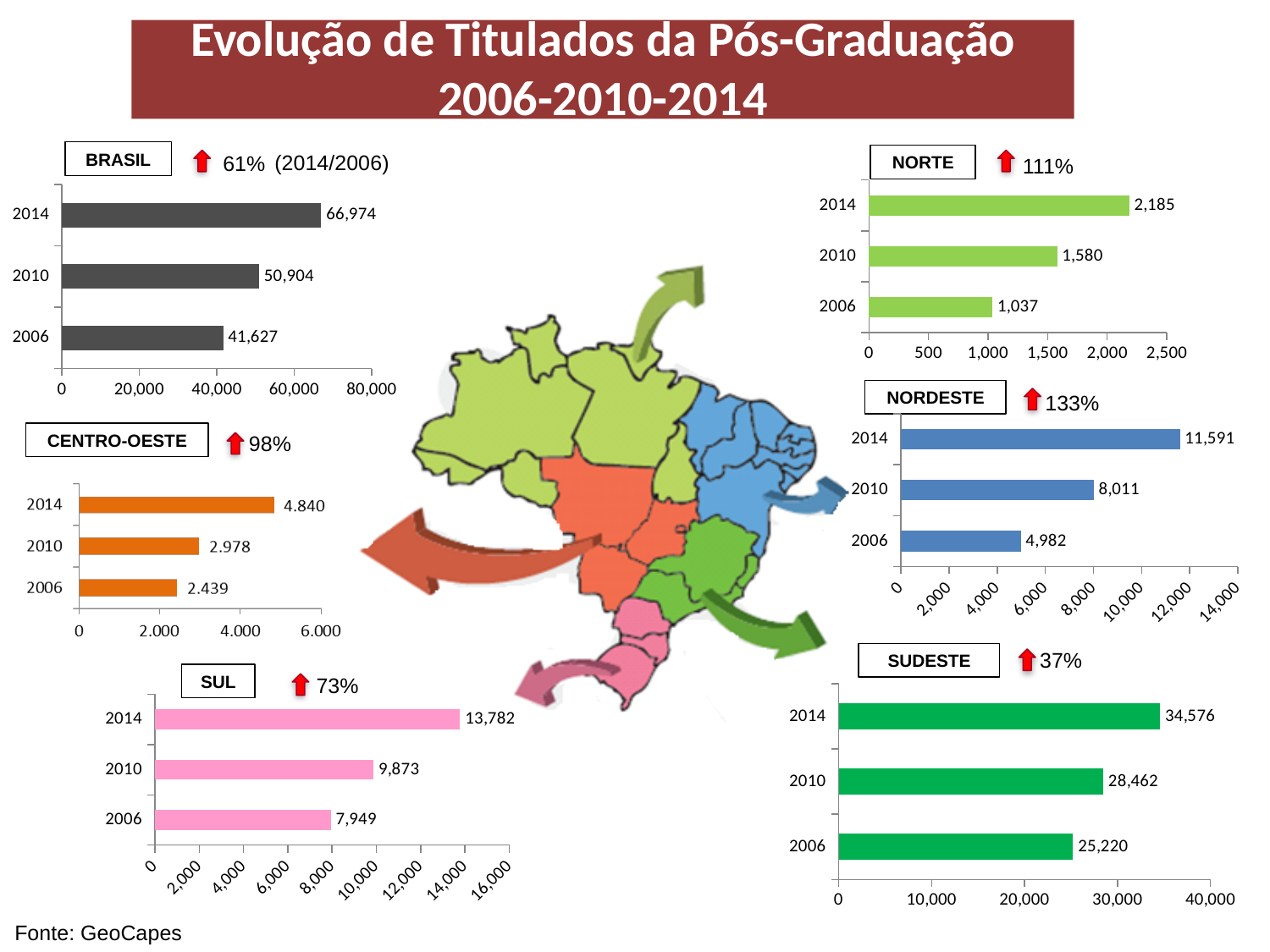
In the NORDESTE chart, what is the difference between the 2014 and 2010 values? 3,580 In the NORTE chart, what is the value for 2006? 1,037 How many bars does the SUDESTE chart show? 3 In the SUL chart, which year has the lowest value? 2006 In the BRASIL chart, what is the value for 2014? 66,974 What percentage increase is shown next to the NORDESTE chart title? 133% In the CENTRO-OESTE chart, what is the value for 2010? 2.978 What kind of chart is the NORTE chart? Bar chart In the SUDESTE chart, what is the value for 2006? 25,220 In the BRASIL chart, what is the difference between the 2014 and 2006 values? 25,347 In the SUL chart, which is larger, the value for 2010 or the value for 2006? 2010 In the NORDESTE chart, which year has the highest value? 2014